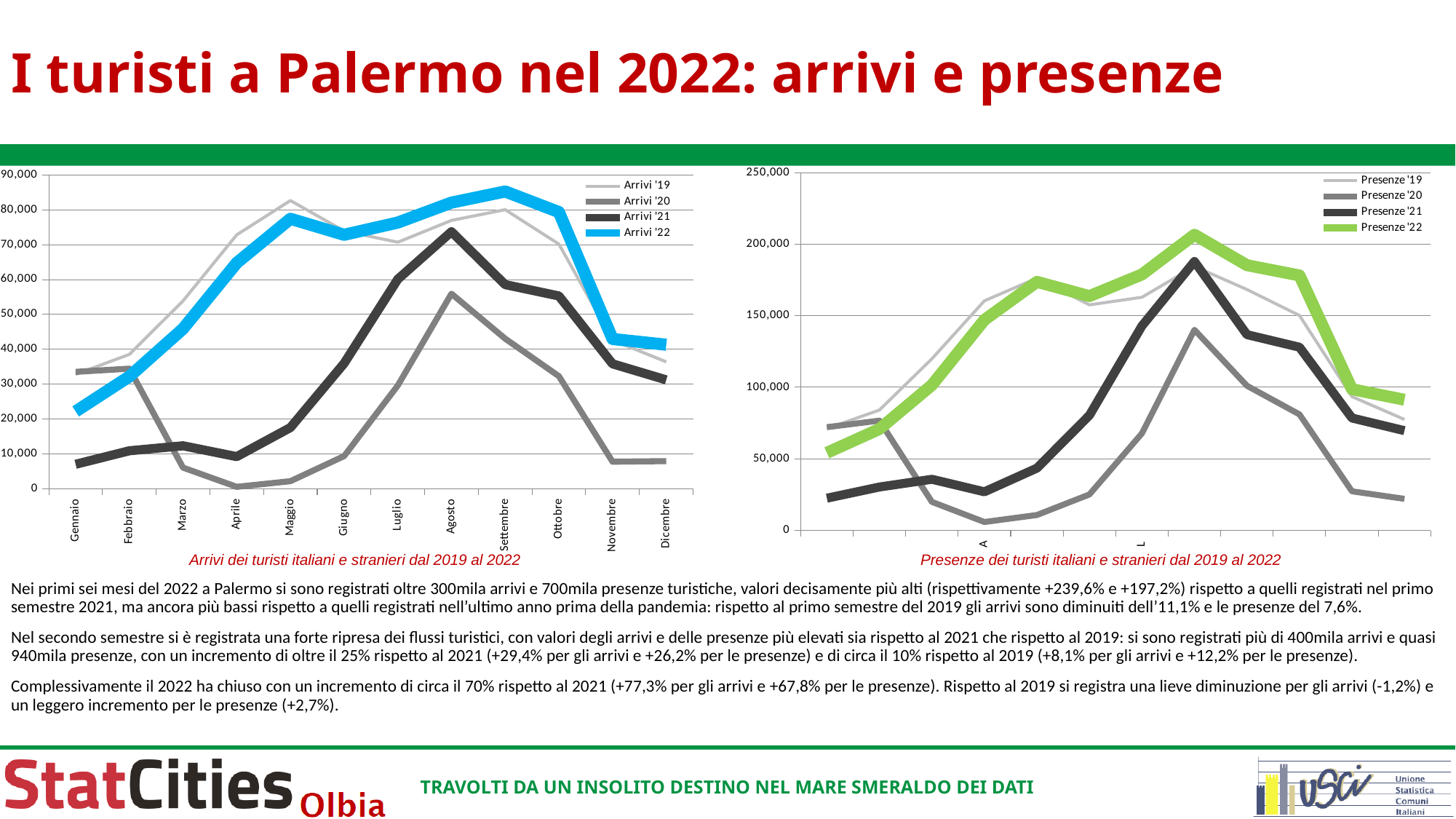
In the left chart (Arrivi), is the value of Arrivi '22 in Settembre greater or less than 80,000? greater In the right chart (Presenze), which series reaches the highest peak? Presenze '22 In the left chart (Arrivi), which is larger in Maggio: Arrivi '22 or Arrivi '21? Arrivi '22 What type of chart is the left chart, 'Arrivi dei turisti italiani e stranieri dal 2019 al 2022'? Line chart In the right chart (Presenze), is the highest value of the Presenze '22 series greater or less than 200,000? greater In the left chart (Arrivi), is the value of Arrivi '20 in Aprile greater or less than 10,000? less In the left chart (Arrivi), in which month is the Arrivi '22 series at its lowest value? Gennaio How many months are shown on the x axis of the left chart (Arrivi)? 12 In the left chart (Arrivi), which is larger in Gennaio: Arrivi '20 or Arrivi '21? Arrivi '20 In the left chart (Arrivi), in which month does the Arrivi '22 series reach its highest value? Settembre How many series does the legend of the left chart (Arrivi) list? 4